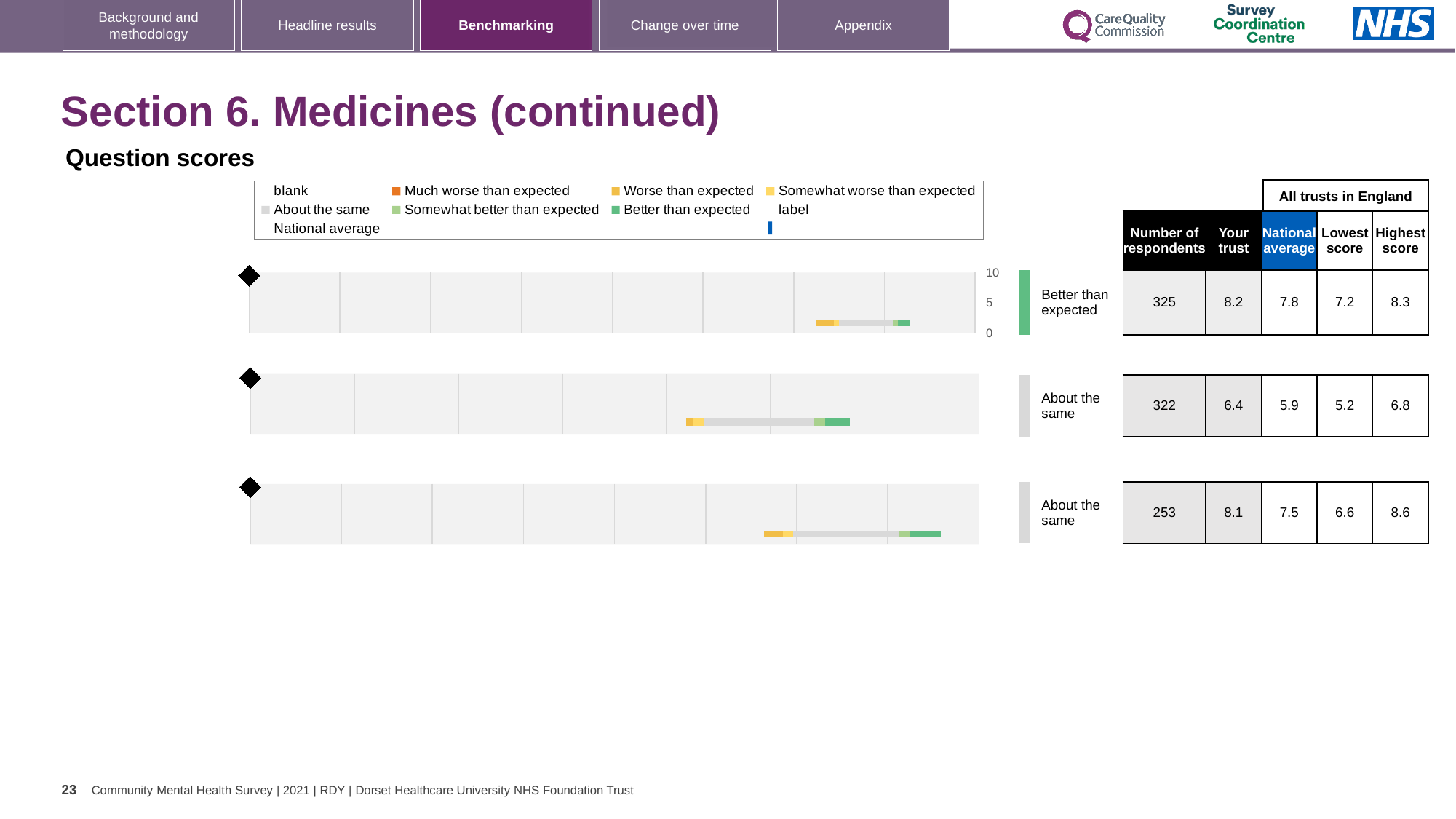
For the top chart, what is the difference between the 'Your trust' score and the national average? 0.4 For the bottom chart, what is the highest score among all trusts in England? 8.6 Which chart (top, middle or bottom) has the lowest national average score? middle How many question score charts are shown on the slide? 3 What colour represents 'Better than expected' in the legend? green What benchmark category is shown next to the top chart? Better than expected For the top chart, what is the 'Your trust' score? 8.2 For the bottom chart, which is larger: the 'Your trust' score or the national average? Your trust Which chart (top, middle or bottom) has the highest 'Your trust' score? top For the bottom chart, how many respondents are there? 253 What kind of chart is used to show the question scores on this slide? bar chart For the middle chart, what is the national average score? 5.9